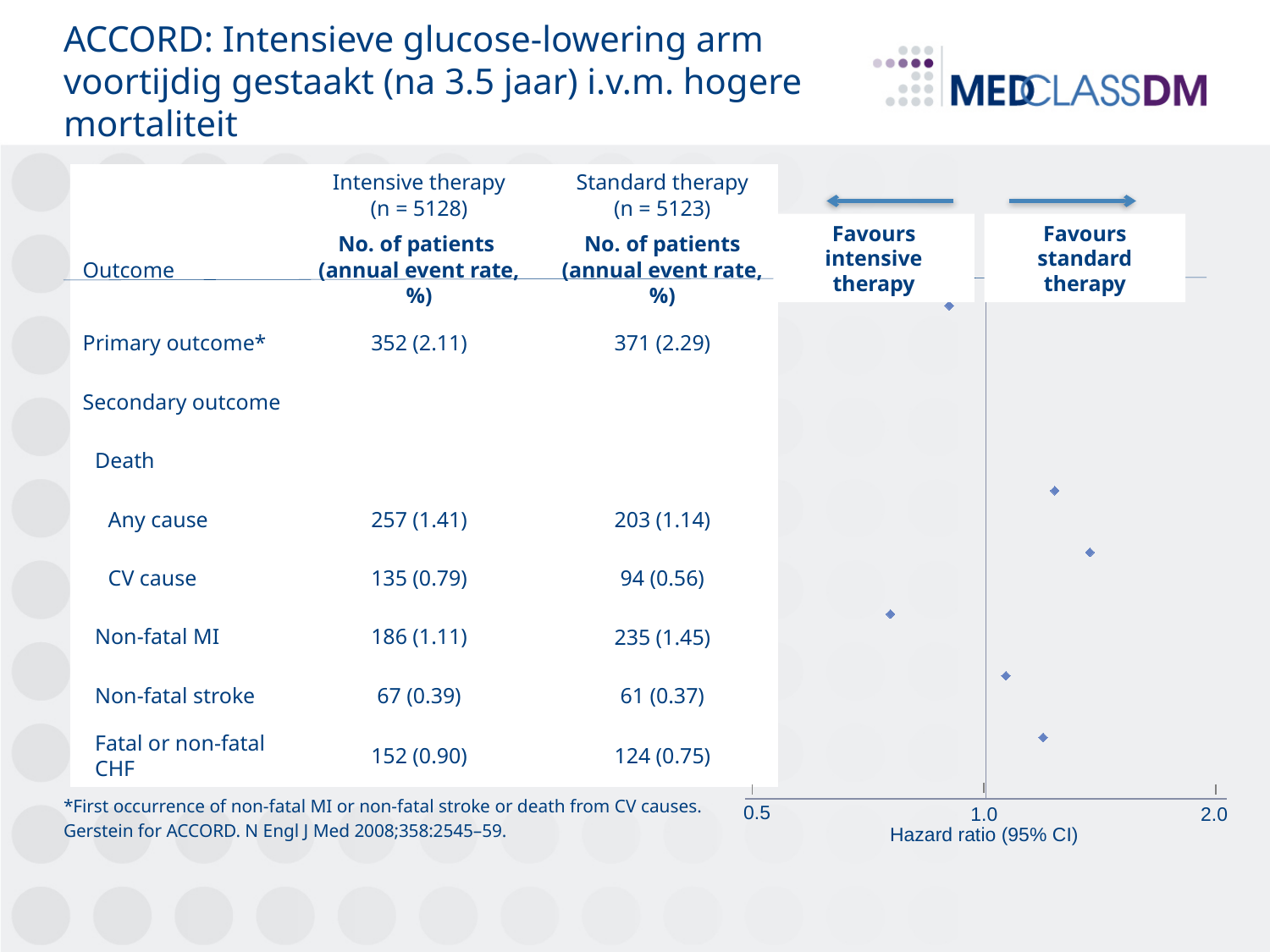
In the hazard ratio chart, is the hazard ratio for death from any cause greater or less than 1.0? greater What is the label of the x axis of the hazard ratio chart? Hazard ratio (95% CI) In the hazard ratio chart, is the hazard ratio for the primary outcome greater or less than 1.0? less In the hazard ratio chart, is the hazard ratio for non-fatal MI greater or less than 1.0? less In the hazard ratio chart, which outcome has the highest hazard ratio? CV cause (death) In the hazard ratio chart, which outcome has the lowest hazard ratio? Non-fatal MI How many data points are plotted in the hazard ratio chart? 6 In the hazard ratio chart, what does the left side of the plot favour according to the label above it? Favours intensive therapy In the hazard ratio chart, which has the larger hazard ratio: death from any cause or non-fatal MI? Death from any cause What kind of chart is shown on the right side of the slide? Scatter chart (forest plot)